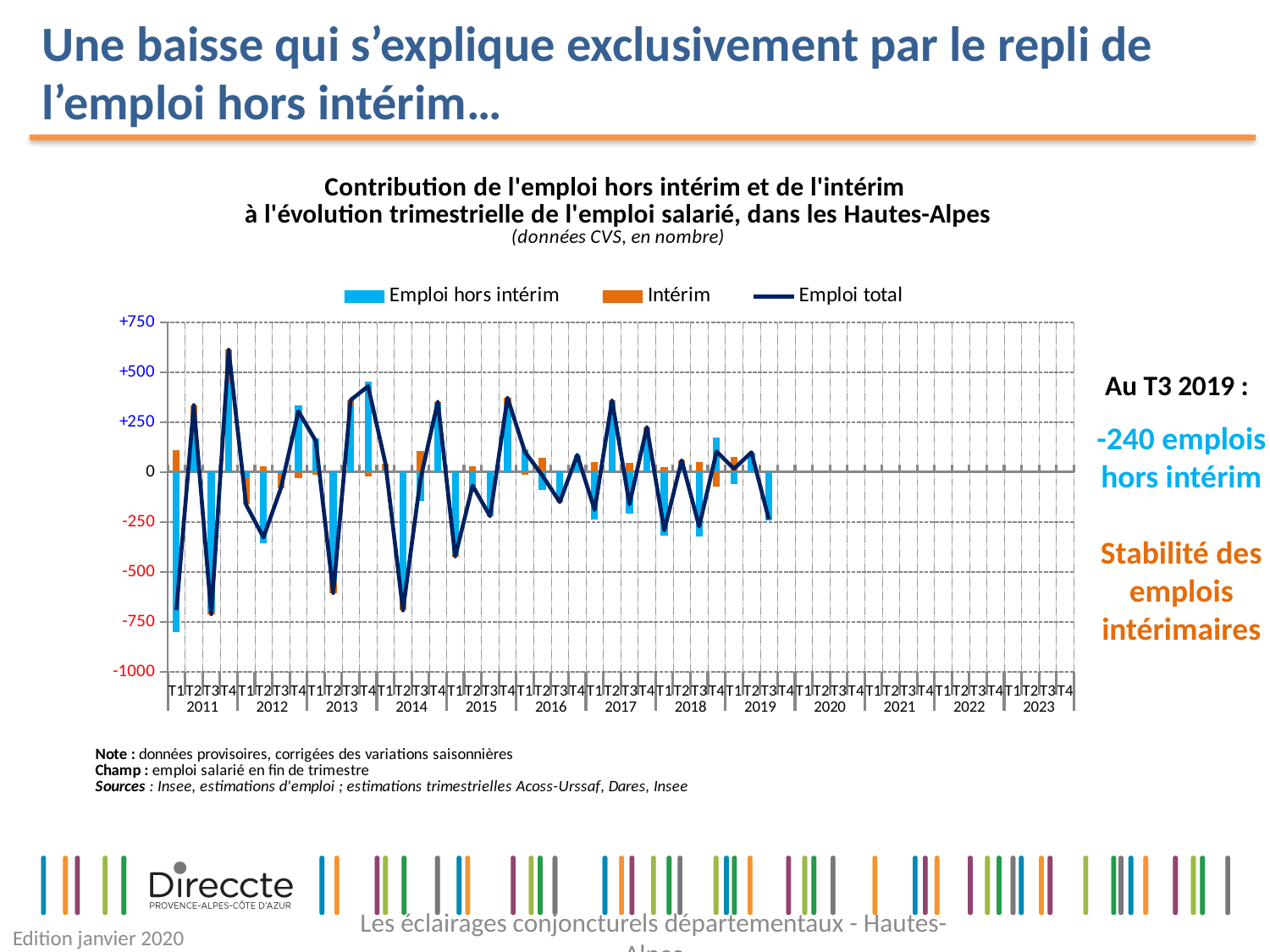
Is the 'Emploi hors intérim' value at T1 2011 greater or less than -500? less What is the last quarter for which data is plotted on the chart? T3 2019 Which is larger, the 'Emploi total' value at T4 2011 or at T4 2013? T4 2011 In which quarter does the 'Emploi total' line reach its highest point? T4 2011 Is the 'Emploi total' value at T4 2011 greater or less than +500? greater Is the 'Emploi hors intérim' value at T4 2013 greater or less than +250? greater Which series is drawn as a dark line rather than bars? Emploi total How many series does the chart legend list? 3 What kind of chart is shown on the slide? Combined bar and line chart What colour are the 'Intérim' bars? Orange What is the value of 'Emploi hors intérim' at T3 2019, as stated on the slide? -240